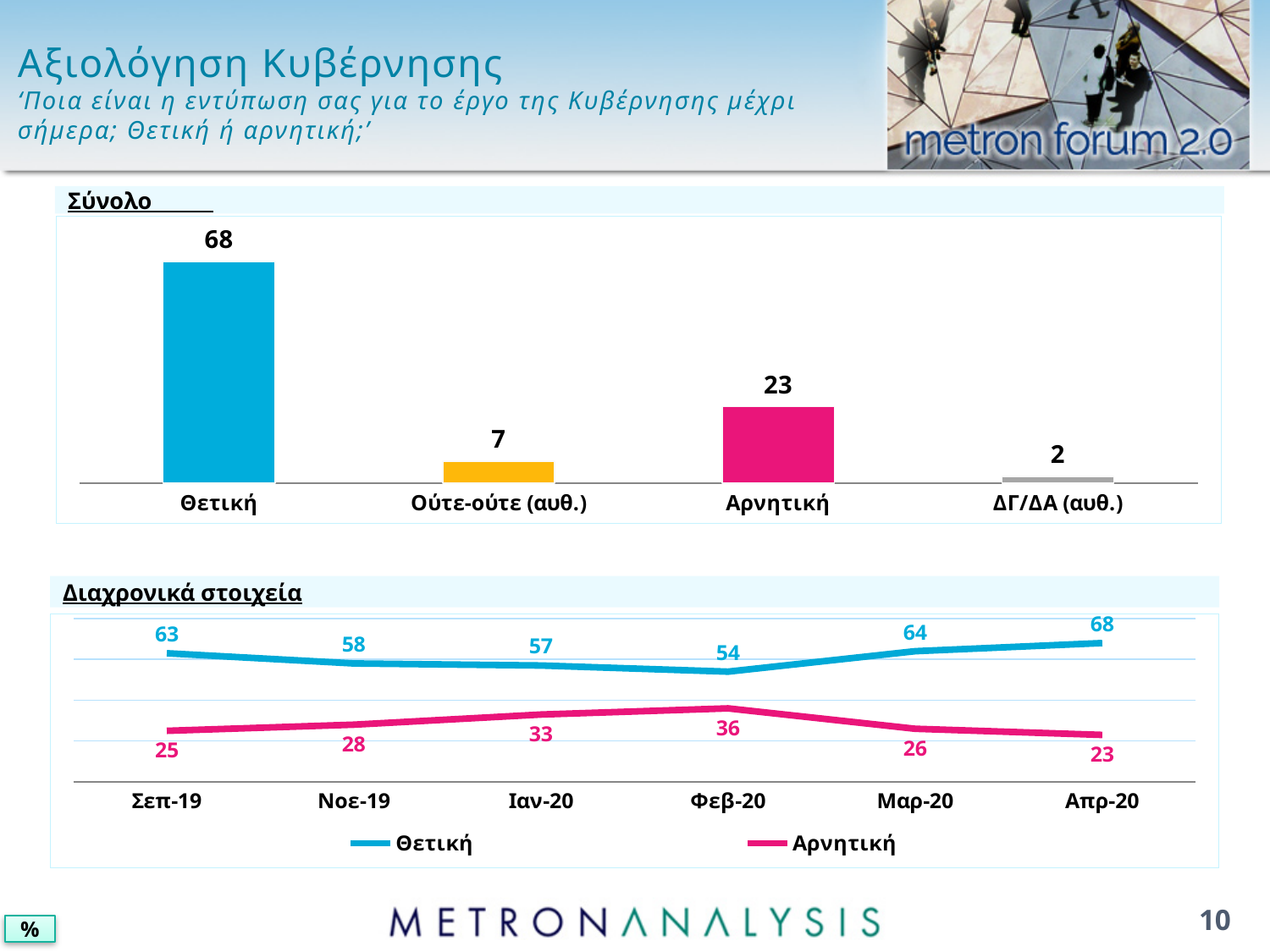
In the 'Σύνολο' chart, what is the value for Αρνητική? 23 In the 'Διαχρονικά στοιχεία' chart, what is the value of Θετική for Φεβ-20? 54 What kind of chart is the 'Σύνολο' chart? Bar chart In the 'Διαχρονικά στοιχεία' chart, does Θετική rise or fall from Φεβ-20 to Απρ-20? Rise In the 'Σύνολο' chart, what is the difference between Θετική and Αρνητική? 45 In the 'Διαχρονικά στοιχεία' chart, how many series does the legend list? 2 In the 'Διαχρονικά στοιχεία' chart, in which month does Αρνητική reach its highest value? Φεβ-20 In the 'Σύνολο' chart, how many categories are shown? 4 In the 'Διαχρονικά στοιχεία' chart, which is larger for Σεπ-19: Θετική or Αρνητική? Θετική In the 'Σύνολο' chart, what is the value for Θετική? 68 In the 'Διαχρονικά στοιχεία' chart, what is the value of Αρνητική for Ιαν-20? 33 In the 'Σύνολο' chart, which category has the lowest value? ΔΓ/ΔΑ (αυθ.)